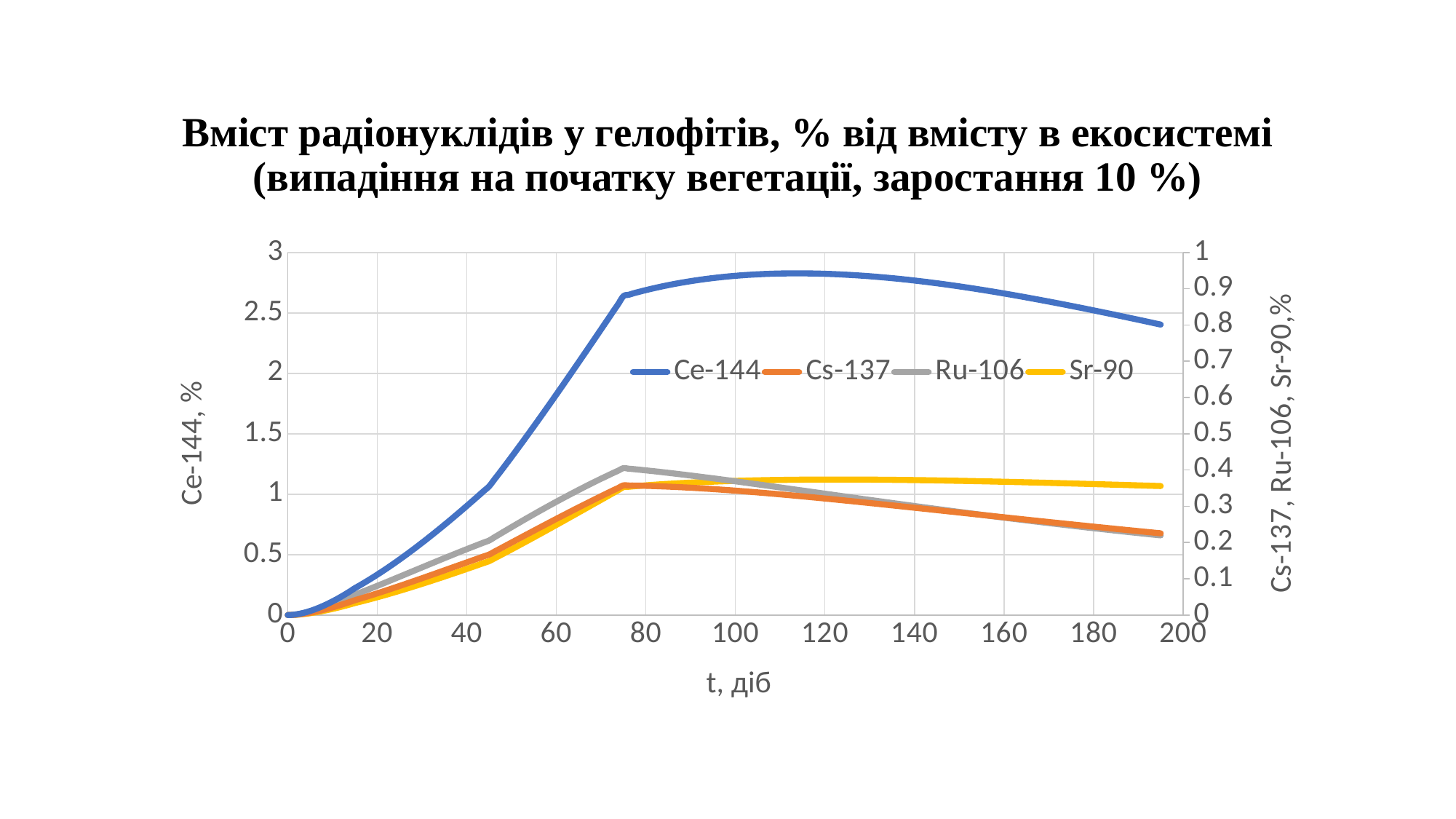
How many series does the legend list? 4 What is the label of the x axis? t, діб Which series is plotted against the left axis labelled "Ce-144, %"? Ce-144 Does the Ce-144 line rise or fall between t = 120 and t = 200? fall At t = 75, which series has the larger value: Ru-106 or Cs-137? Ru-106 What kind of chart is shown on the slide? line chart Is the value of Ce-144 at t = 75 greater or less than 2.5 on the left axis? greater Is the value of Ce-144 at t = 195 greater or less than 2.5 on the left axis? less Is the value of Cs-137 at t = 195 greater or less than 0.3 on the right axis? less